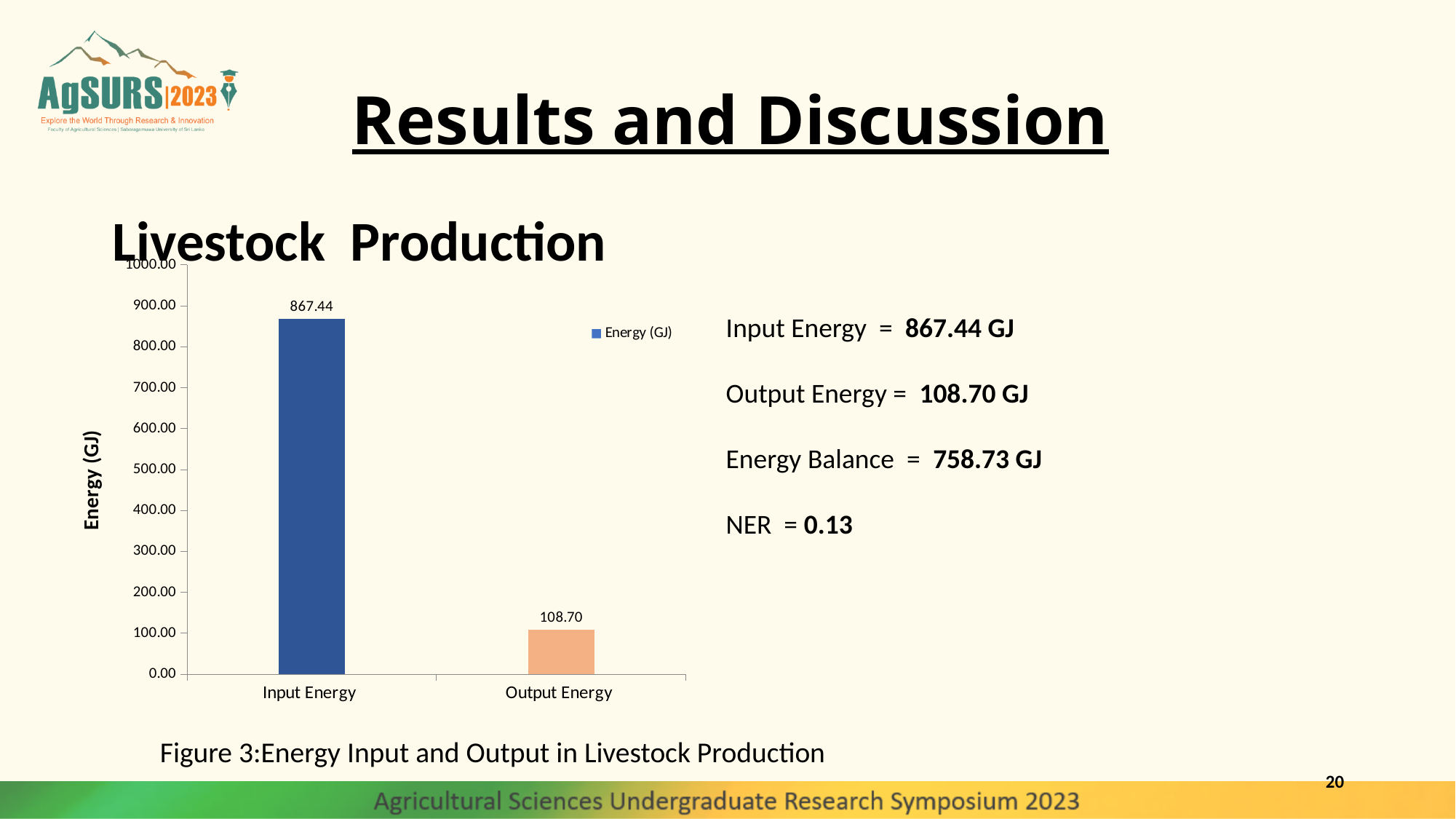
What is the label of the y axis of the chart? Energy (GJ) What is the value for Input Energy in the chart? 867.44 What kind of chart is shown on the slide? bar chart How many categories are shown on the x axis of the chart? 2 Which category has the lowest value in the chart? Output Energy What is the difference between the Input Energy and Output Energy values in the chart? 758.74 Is the value for Input Energy greater or less than 800.00? greater How many series does the chart legend list? 1 Which category has the highest value in the chart? Input Energy Is the value for Output Energy greater or less than 200.00? less Which is larger in the chart, Input Energy or Output Energy? Input Energy What is the value for Output Energy in the chart? 108.70